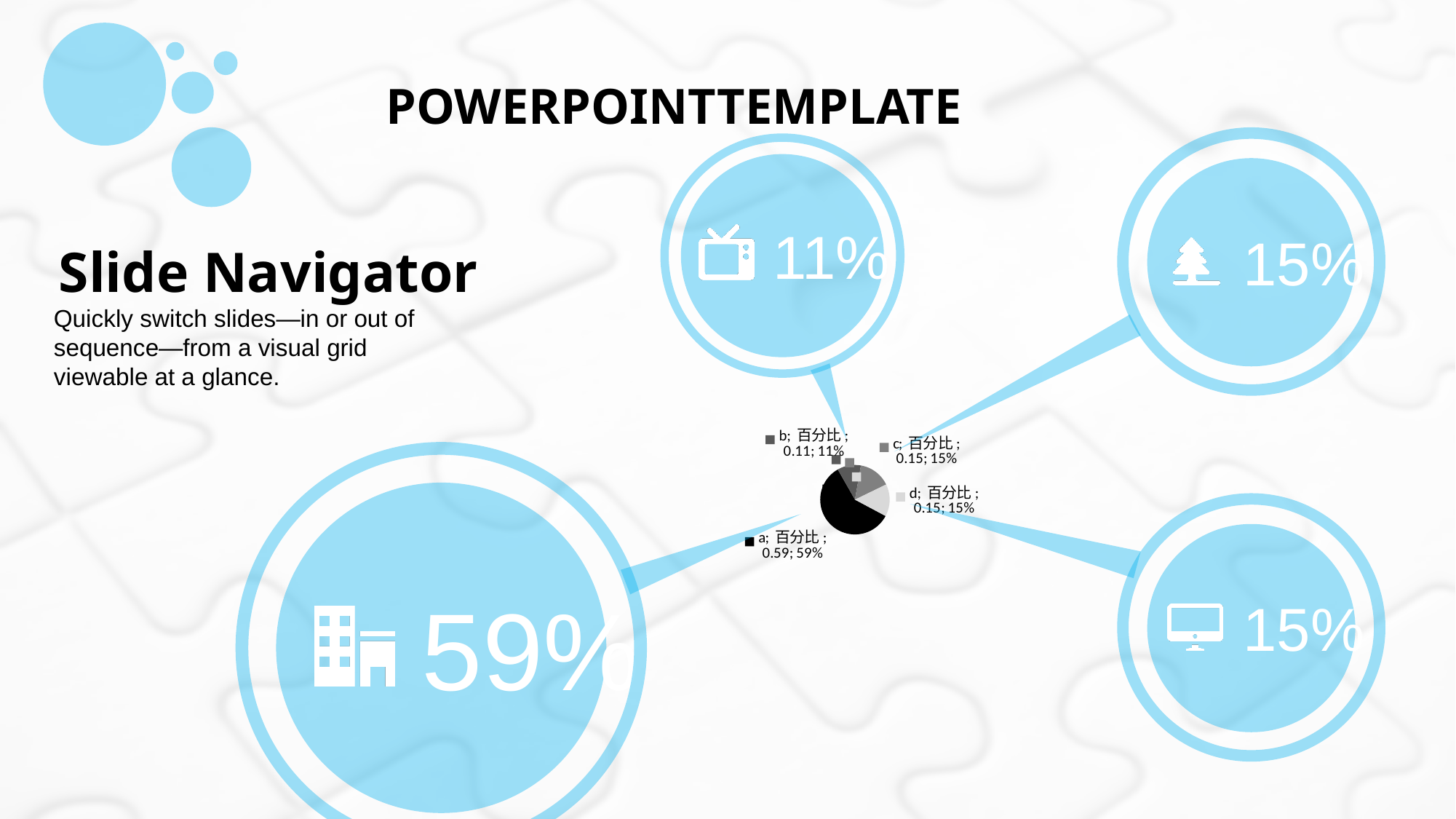
Which slice of the pie chart is the largest? a What percentage does slice b represent in the pie chart? 11% What percentage does slice a represent in the pie chart? 59% What is the difference in percentage points between slice a and slice b in the pie chart? 48 What kind of chart is shown on the slide? pie chart What colour is the largest slice of the pie chart? black What is the series name shown in the pie chart's data labels? 百分比 How many slices does the pie chart have? 4 What is the value printed for slice d in the pie chart? 0.15 Which slice of the pie chart is the smallest? b Which is larger in the pie chart, slice c or slice b? c What percentage does slice c represent in the pie chart? 15%